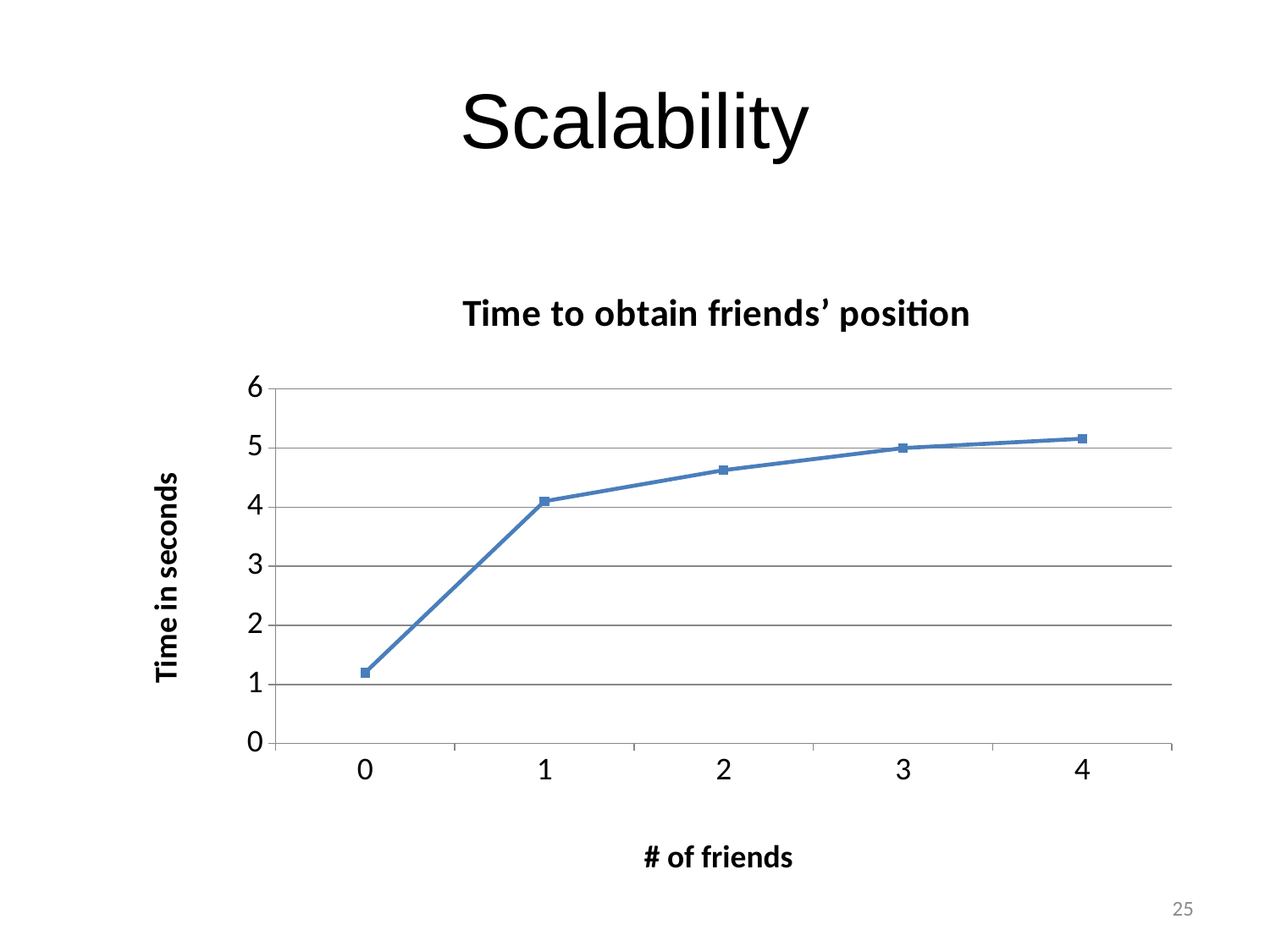
Which has a larger time in seconds, 0 friends or 1 friend? 1 friend Is the time for 0 friends greater or less than 2 seconds? less At which number of friends is the time in seconds lowest? 0 What is the label of the y axis? Time in seconds Is the time for 2 friends greater or less than 4 seconds? greater What is the title of the chart? Time to obtain friends' position How many data points are plotted on the line? 5 Is the time for 4 friends greater or less than 6 seconds? less What kind of chart is shown on the slide? line chart At which number of friends is the time in seconds highest? 4 Does the time in seconds rise or fall as the number of friends increases? rises